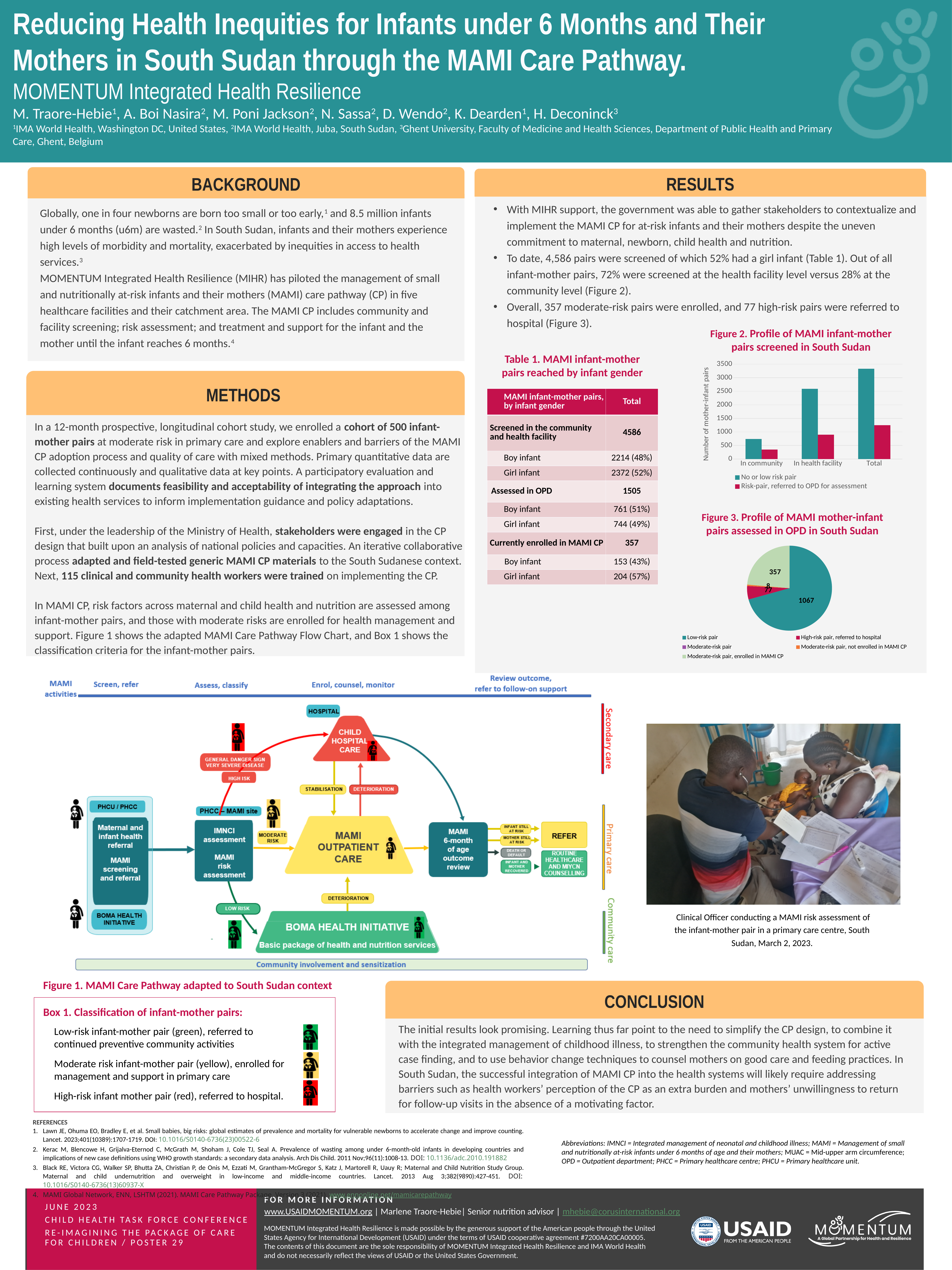
In Figure 2, is the value for 'No or low risk pair' in health facility greater or less than 2000? greater In Figure 2, how many series does the legend list? 2 In Figure 2, how many categories are shown on the x axis? 3 In Figure 3, what is the value shown for the 'Low-risk pair' slice? 1067 In Figure 3, what is the value shown for the 'High-risk pair, referred to hospital' slice? 77 In Figure 2, what is the label of the y axis? Number of mother-infant pairs In Figure 2, for 'In health facility', which series has the larger value: 'No or low risk pair' or 'Risk-pair, referred to OPD for assessment'? No or low risk pair What kind of chart is Figure 2, 'Profile of MAMI infant-mother pairs screened in South Sudan'? bar chart What kind of chart is Figure 3, 'Profile of MAMI mother-infant pairs assessed in OPD in South Sudan'? pie chart In Figure 2, is the value for 'Risk-pair, referred to OPD for assessment' in community greater or less than 500? less In Figure 3, what is the difference between the 'Low-risk pair' slice (1067) and the 'Moderate-risk pair, enrolled in MAMI CP' slice (357)? 710 In Figure 2, which category has the highest 'No or low risk pair' bar? Total